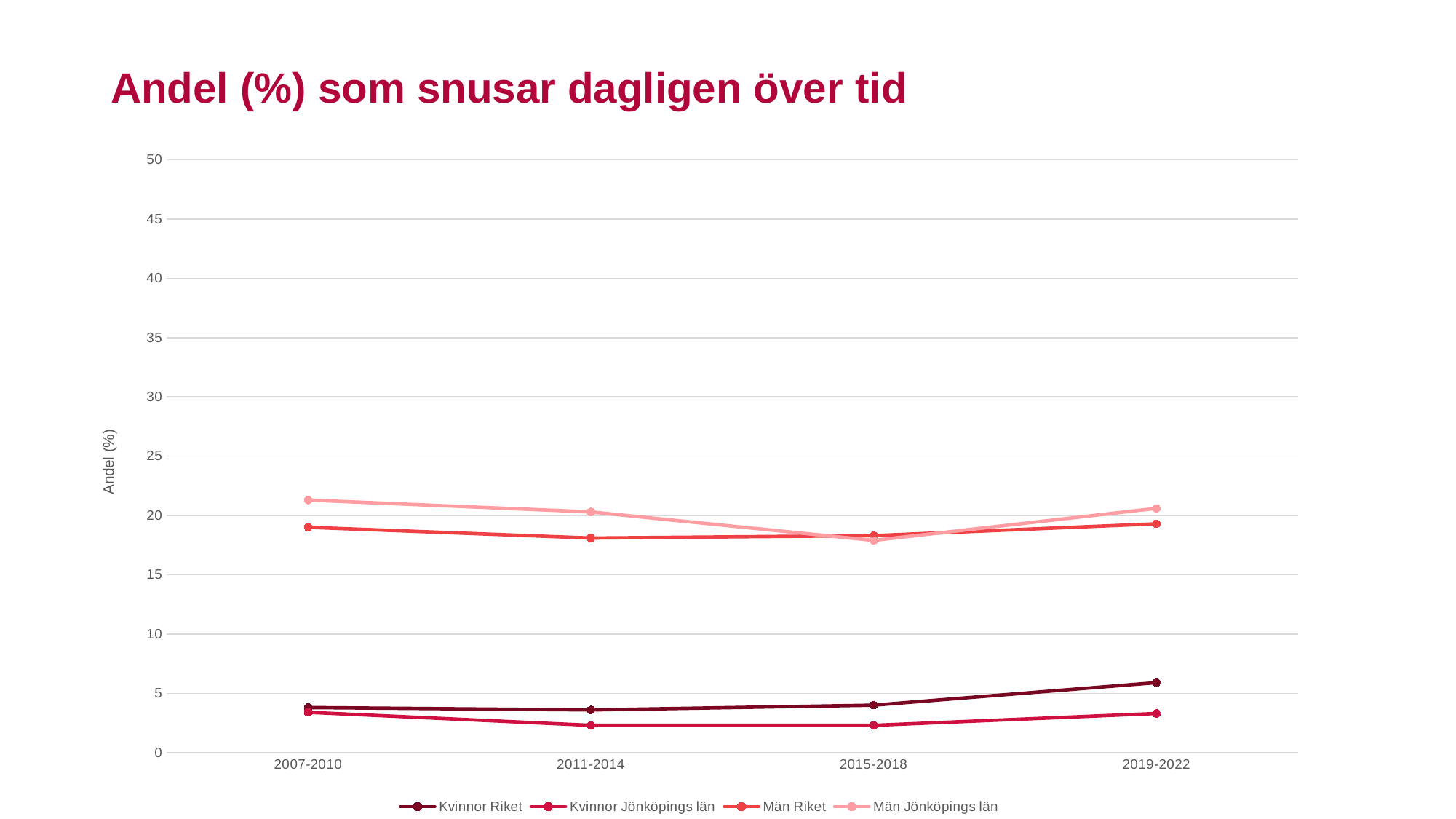
What is the label on the y axis? Andel (%) Is the value for Män Jönköpings län in 2007-2010 greater or less than 20? greater Is the value for Kvinnor Riket in 2019-2022 greater or less than 5? greater Does the value for Kvinnor Riket rise or fall from 2015-2018 to 2019-2022? rise In 2019-2022, which is larger: Kvinnor Riket or Kvinnor Jönköpings län? Kvinnor Riket In which period is the value for Män Jönköpings län lowest? 2015-2018 In which period is the value for Kvinnor Riket highest? 2019-2022 Is the value for Kvinnor Jönköpings län in 2011-2014 greater or less than 5? less What kind of chart is shown on the slide? line chart In 2007-2010, which is larger: Män Jönköpings län or Män Riket? Män Jönköpings län How many series does the legend list? 4 How many time periods are shown on the x axis? 4